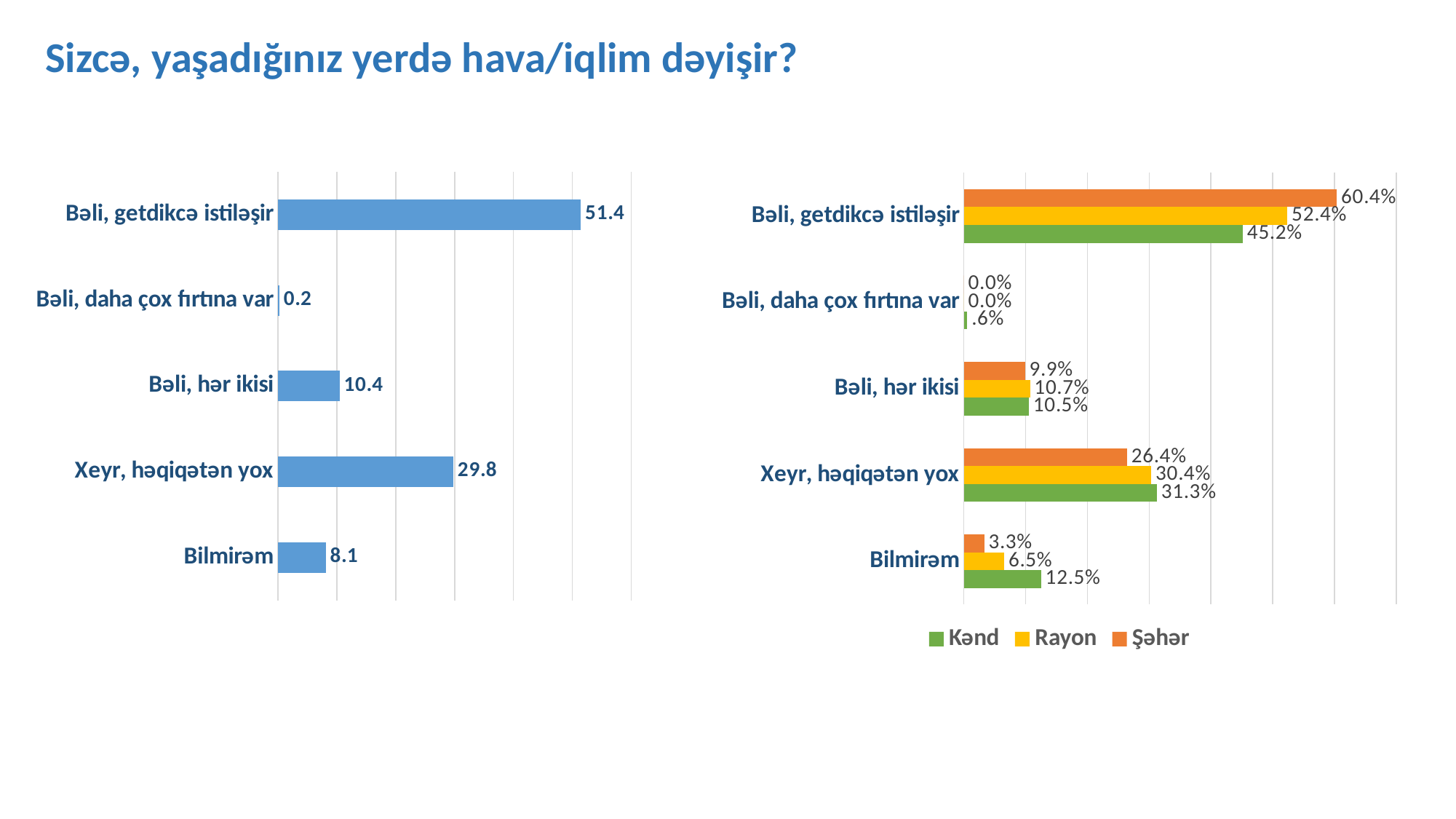
In the right chart, what is the difference between the Rayon and Şəhər values for "Xeyr, həqiqətən yox"? 4.0% In the right chart, which series is shown in green? Kənd In the right chart, what is the Şəhər value for "Bəli, getdikcə istiləşir"? 60.4% In the right chart, what is the Kənd value for "Bilmirəm"? 12.5% In the right chart, which series has the highest value for "Bəli, getdikcə istiləşir"? Şəhər In the left chart, what is the difference between "Bəli, getdikcə istiləşir" and "Xeyr, həqiqətən yox"? 21.6 In the left chart, which category has the lowest value? Bəli, daha çox fırtına var What kind of chart is the left chart? bar chart In the right chart, for "Bilmirəm", is the Kənd value or the Şəhər value larger? Kənd In the right chart, how many series does the legend list? 3 In the left chart, what is the value for "Bəli, getdikcə istiləşir"? 51.4 In the left chart, how many categories are shown? 5